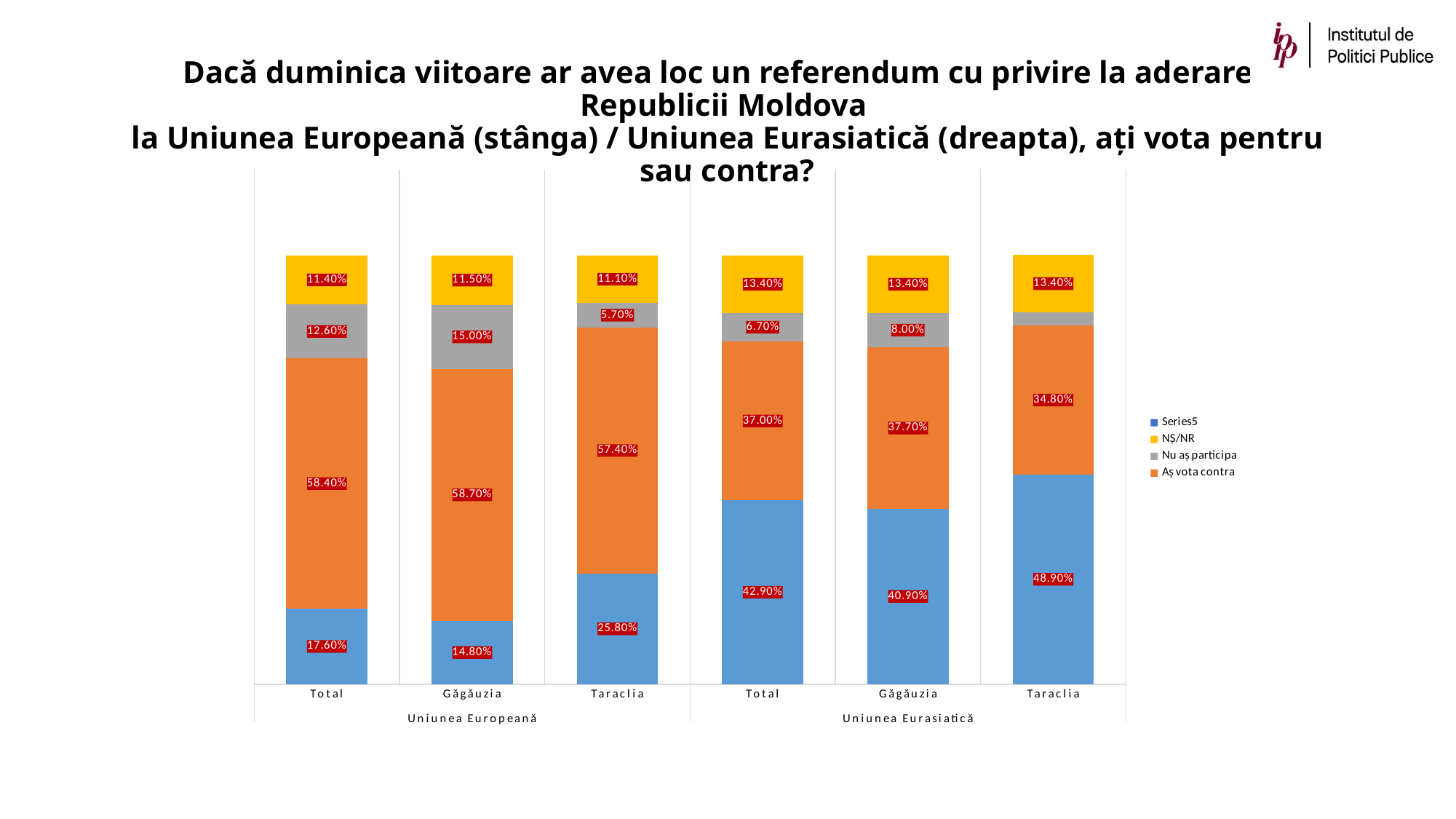
What kind of chart is shown on the slide? stacked bar chart Which is larger: the 'Series5' value for Taraclia under Uniunea Europeană or the 'Series5' value for Găgăuzia under Uniunea Eurasiatică? Găgăuzia (Uniunea Eurasiatică) Which bar has the lowest 'Series5' value? Găgăuzia (Uniunea Europeană) What is the 'Series5' value for Taraclia under Uniunea Eurasiatică? 48.90% Which bar has the highest 'Series5' value? Taraclia (Uniunea Eurasiatică) What is the difference between the 'Aș vota contra' values for Total under Uniunea Europeană and Total under Uniunea Eurasiatică? 21.40% How many series does the legend list? 4 What is the 'NȘ/NR' value for Total under Uniunea Eurasiatică? 13.40% What colour represents 'Aș vota contra' in the chart? orange What is the 'Nu aș participa' value for Găgăuzia under Uniunea Europeană? 15.00% How many bars are plotted in the chart? 6 What is the 'Aș vota contra' value for Total under Uniunea Europeană? 58.40%